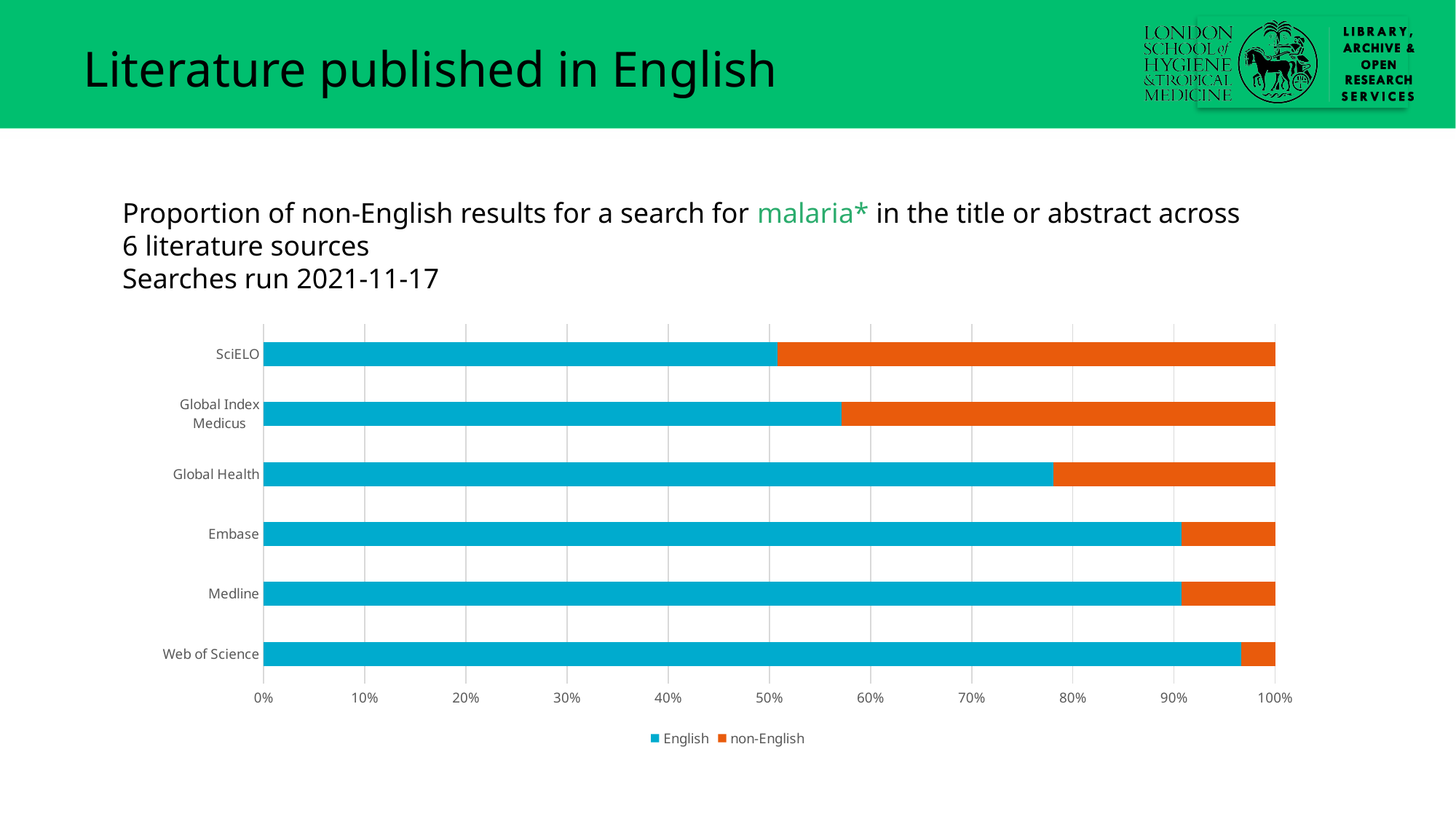
Which literature source has the highest proportion of English results? Web of Science Which literature source has the lowest proportion of English results? SciELO Is the English proportion for Web of Science greater or less than 90%? greater How many literature sources are listed on the chart's vertical axis? 6 Which colour represents the non-English series in the chart? Orange Which literature source has the largest non-English share? SciELO What kind of chart is shown on the slide? Stacked bar chart How many series does the chart legend list? 2 Which has a larger English share, Global Health or Global Index Medicus? Global Health Is the English proportion for Global Health greater or less than 70%? greater Is the English proportion for SciELO greater or less than 60%? less